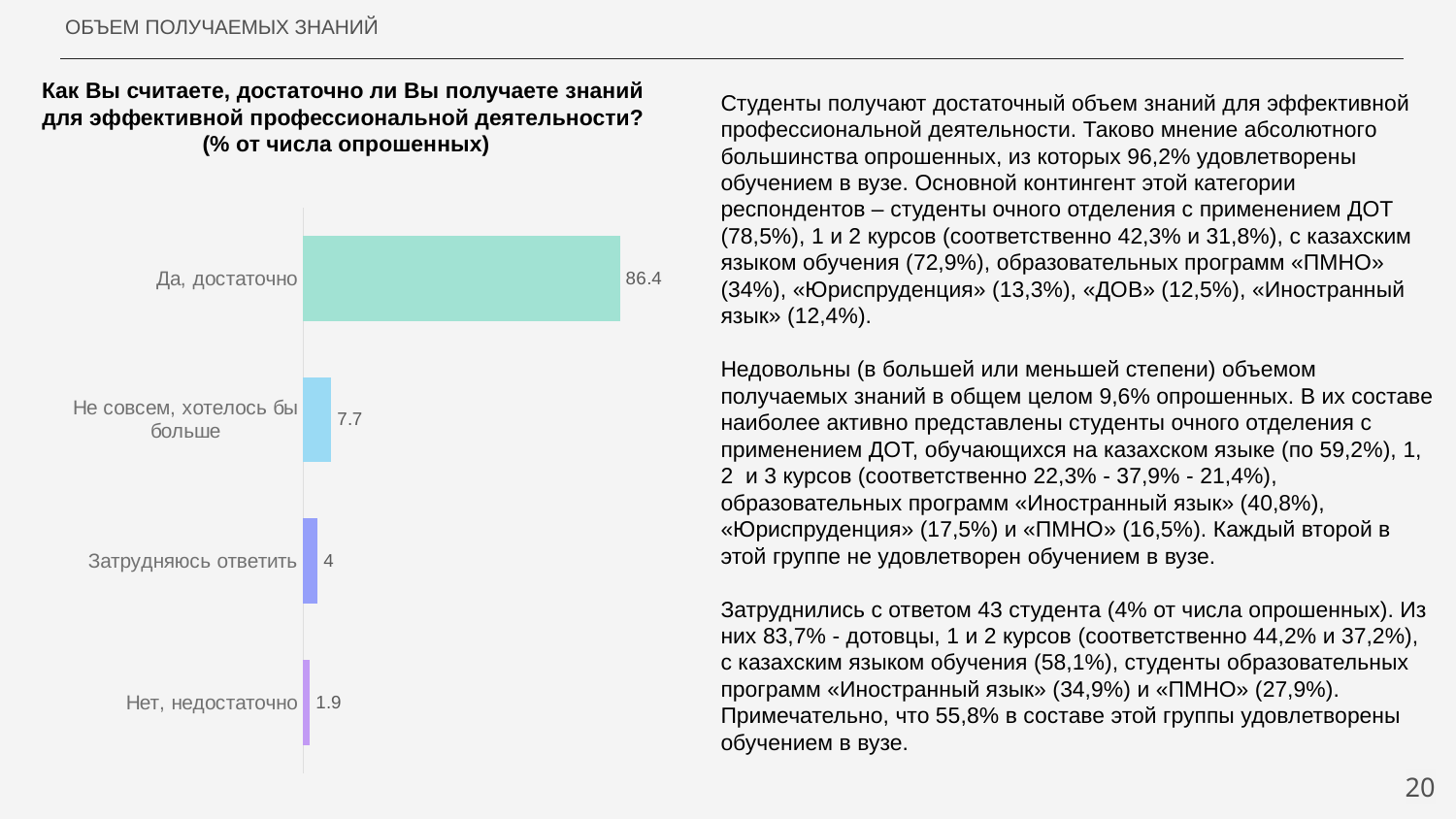
Which is larger: the value for "Не совсем, хотелось бы больше" or for "Затрудняюсь ответить"? Не совсем, хотелось бы больше What is the value for "Нет, недостаточно"? 1.9 What is the difference between the values for "Затрудняюсь ответить" and "Нет, недостаточно"? 2.1 Which category has the highest value? Да, достаточно What is the value for "Затрудняюсь ответить"? 4 What is the title of the chart? Как Вы считаете, достаточно ли Вы получаете знаний для эффективной профессиональной деятельности? (% от числа опрошенных) Which category has the lowest value? Нет, недостаточно What is the value for "Да, достаточно"? 86.4 How many categories are shown in the chart? 4 What is the difference between the values for "Да, достаточно" and "Не совсем, хотелось бы больше"? 78.7 What kind of chart is shown on the slide? Bar chart What is the value for "Не совсем, хотелось бы больше"? 7.7